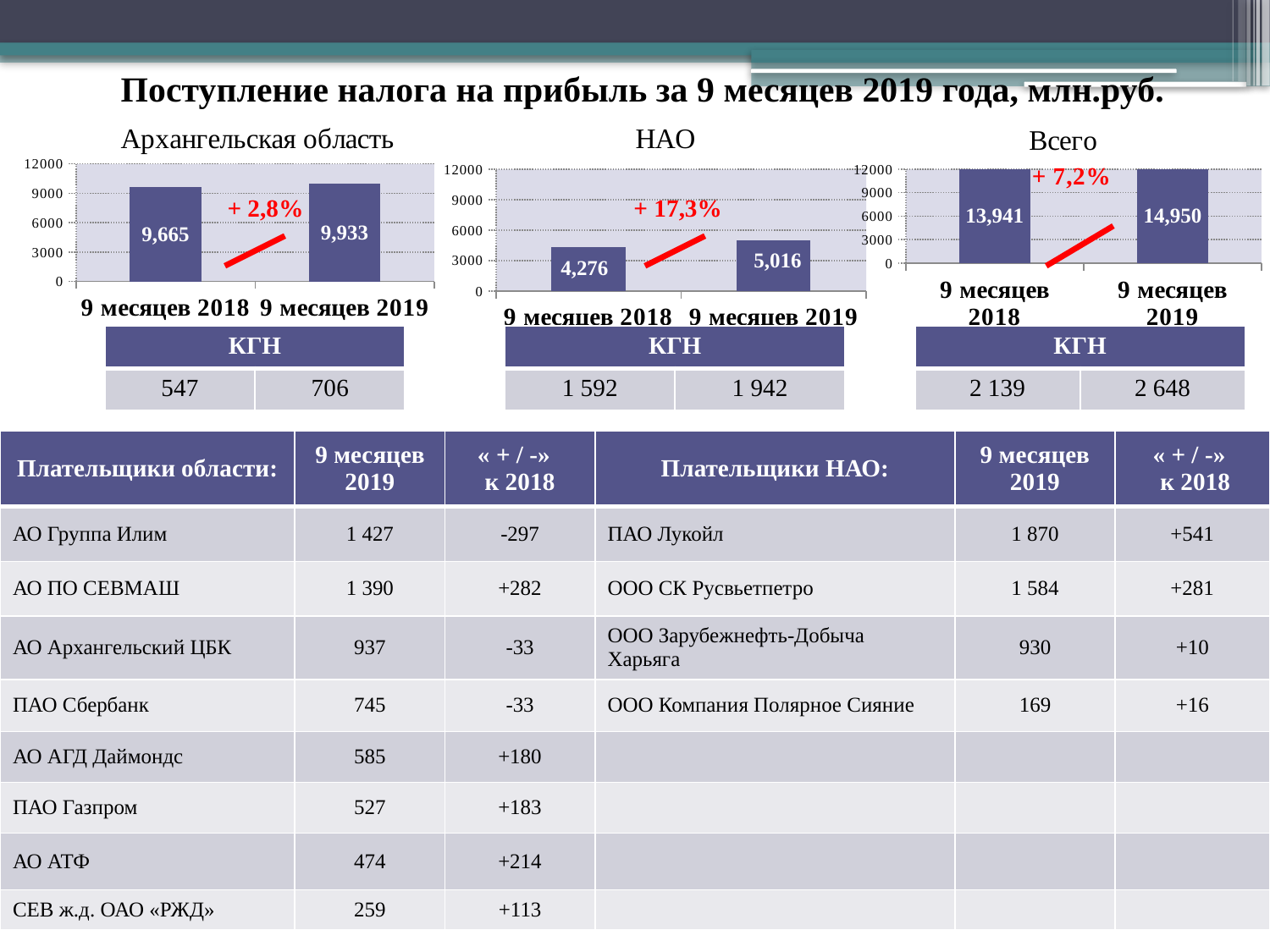
In the Всего chart, what is the difference between the 9 месяцев 2019 and 9 месяцев 2018 values? 1,009 In the НАО chart, what is the difference between the 9 месяцев 2019 and 9 месяцев 2018 values? 740 In the Всего chart, what is the value for 9 месяцев 2018? 13,941 In the НАО chart, which period has the higher value? 9 месяцев 2019 What percentage change is annotated on the НАО chart? + 17,3% In the НАО chart, what is the value for 9 месяцев 2018? 4,276 In the Всего chart, what is the value for 9 месяцев 2019? 14,950 What kind of chart is the Всего chart? bar chart In the Архангельская область chart, which period has the lower value? 9 месяцев 2018 In the Архангельская область chart, is the value for 9 месяцев 2019 greater or less than 9000? greater How many categories are shown on the x axis of the НАО chart? 2 In the Архангельская область chart, what is the value for 9 месяцев 2019? 9,933